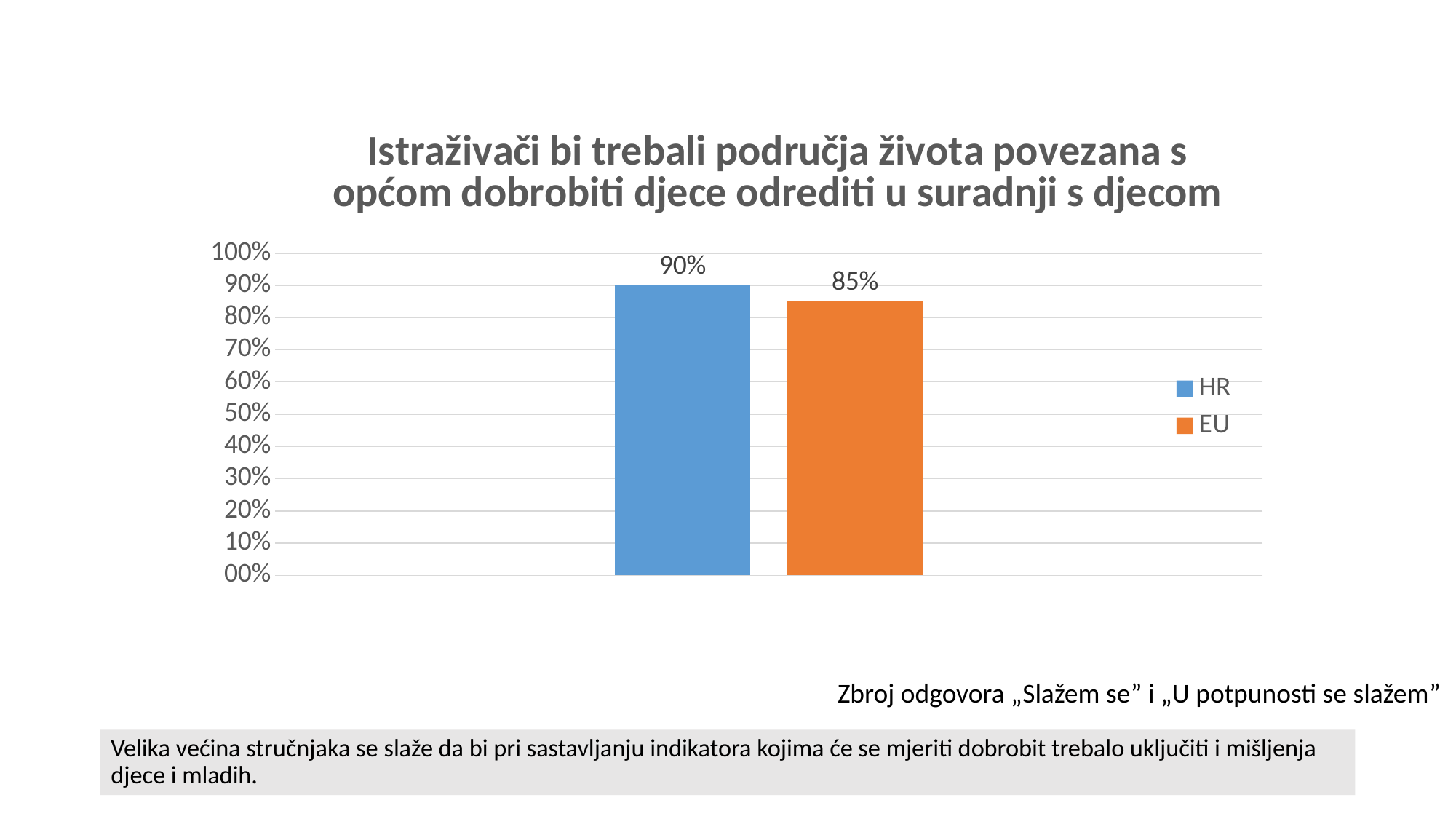
How many bars are plotted on the chart? 2 Which series has the higher value, HR or EU? HR How many series does the legend list? 2 Is the value for HR greater or less than 100%? less Is the value for EU greater or less than 80%? greater What colour is the bar for EU? Orange Which series has the lowest value? EU What is the value for EU? 85% What is the maximum value shown on the vertical axis? 100% What is the value for HR? 90% What kind of chart is shown on the slide? Bar chart What is the difference between the HR and EU values? 5%